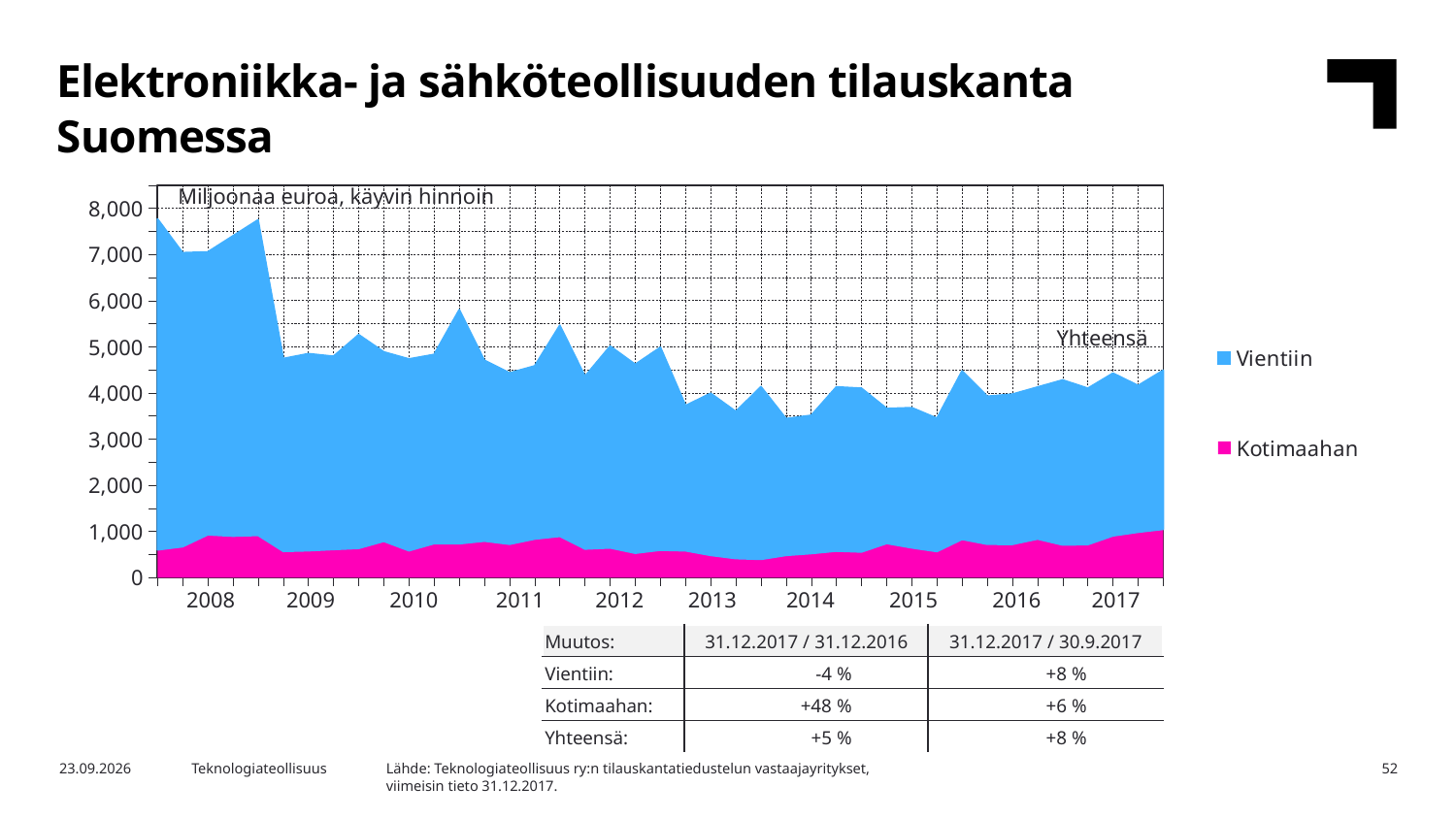
How many series does the legend list? 2 Which series, Vientiin or Kotimaahan, has the larger values throughout the chart? Vientiin Is the total order book (Yhteensä) at the start of 2008 greater or less than 7,000? greater Is the total order book (Yhteensä) at the end of 2017 greater or less than 5,000? less What are the two series named in the legend? Vientiin and Kotimaahan Does the total order book overall rise or fall from 2008 to 2017? fall How many years are labelled on the x axis? 10 Is the total order book (Yhteensä) in mid-2015 greater or less than 4,000? less What unit is stated at the top of the chart area? Miljoonaa euroa, käyvin hinnoin What kind of chart is shown on the slide? Stacked area chart In which year does the total order book reach its highest level? 2008